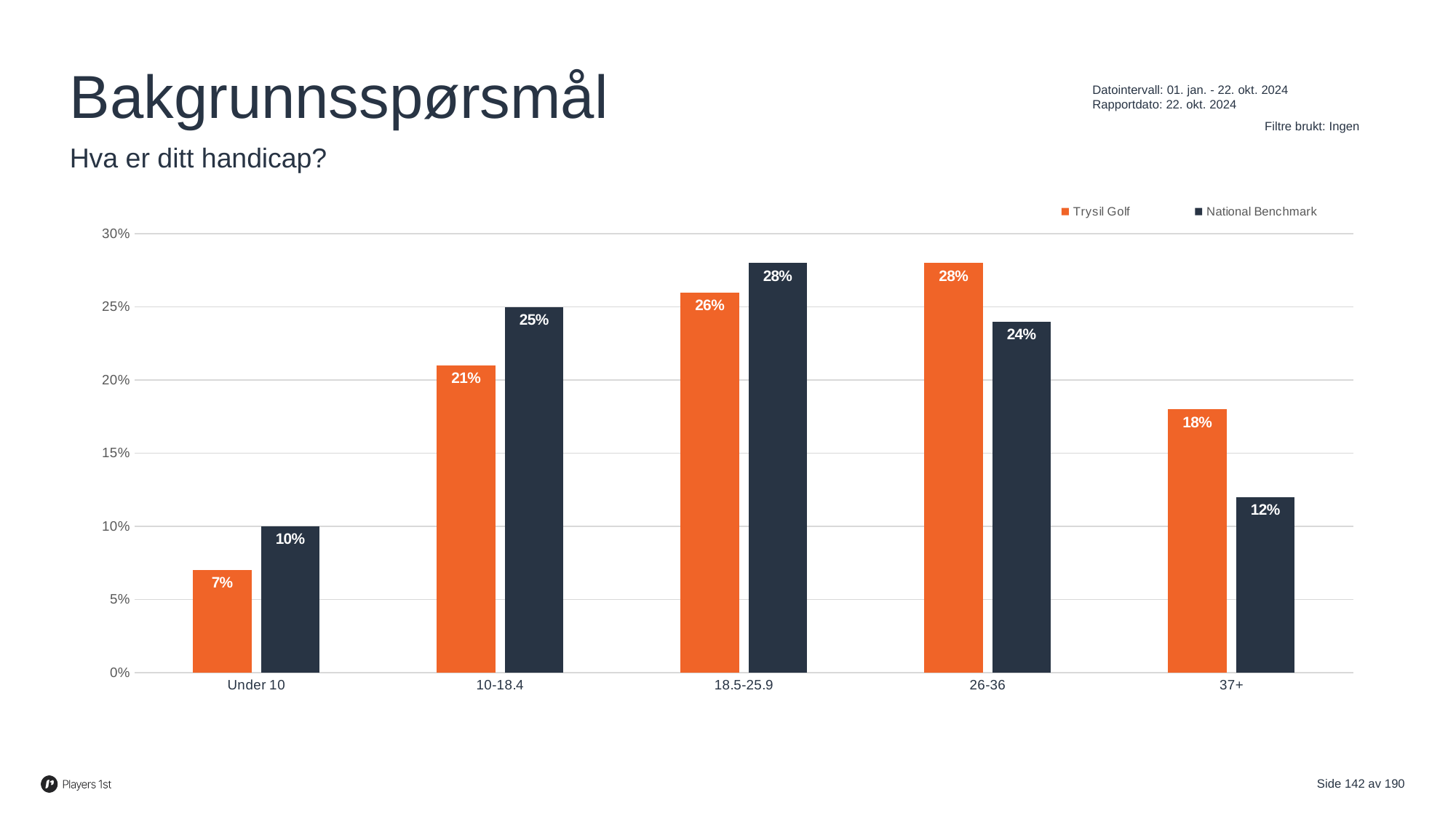
Which handicap category has the highest Trysil Golf value? 26-36 What is the Trysil Golf value for the 10-18.4 handicap category? 21% How many handicap categories are shown on the x axis? 5 Is the Trysil Golf value for 37+ greater or less than 15%? greater Which handicap category has the lowest National Benchmark value? Under 10 What is the Trysil Golf value for the Under 10 category? 7% What is the difference between the Trysil Golf and National Benchmark values for the 26-36 category? 4% What is the National Benchmark value for the 37+ handicap category? 12% How many series does the legend list? 2 For the 18.5-25.9 category, which is larger: Trysil Golf or National Benchmark? National Benchmark What kind of chart is shown on the slide? Bar chart Which colour represents Trysil Golf in the chart? Orange